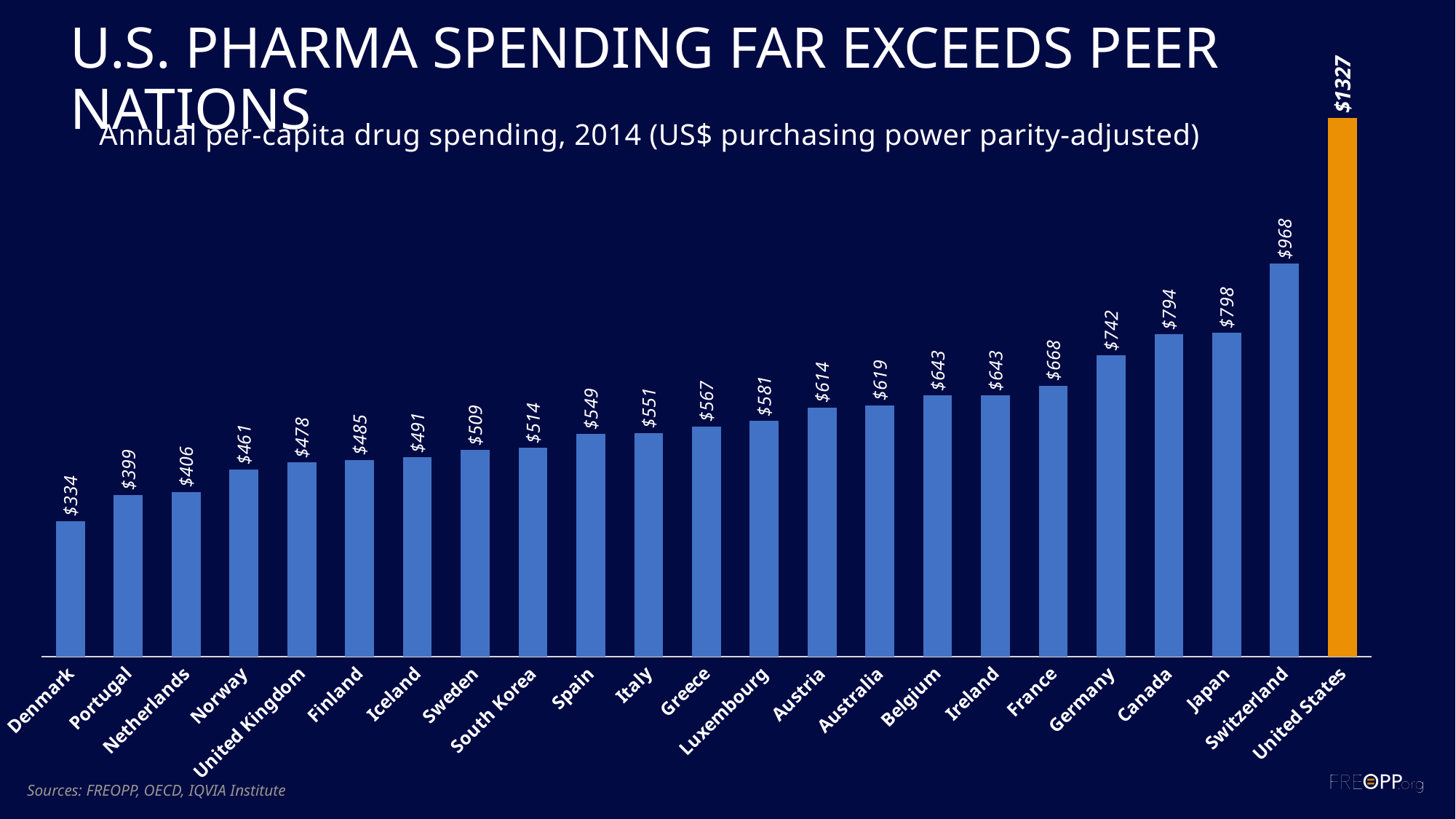
What is the difference between the Germany value and the France value? $74 What is the value shown for Switzerland? $968 What kind of chart is shown on the slide? Bar chart How many countries are shown on the chart? 23 What is the difference between the United States value and the Switzerland value? $359 What is the annual per-capita drug spending shown for the United States? $1327 Which country has the highest per-capita drug spending on the chart? United States Which country has the lowest per-capita drug spending on the chart? Denmark Which is larger, the value for Canada or the value for Germany? Canada Which country's bar is coloured orange instead of blue? United States Do the values rise or fall moving from left to right along the x axis? Rise What is the value shown for the United Kingdom? $478